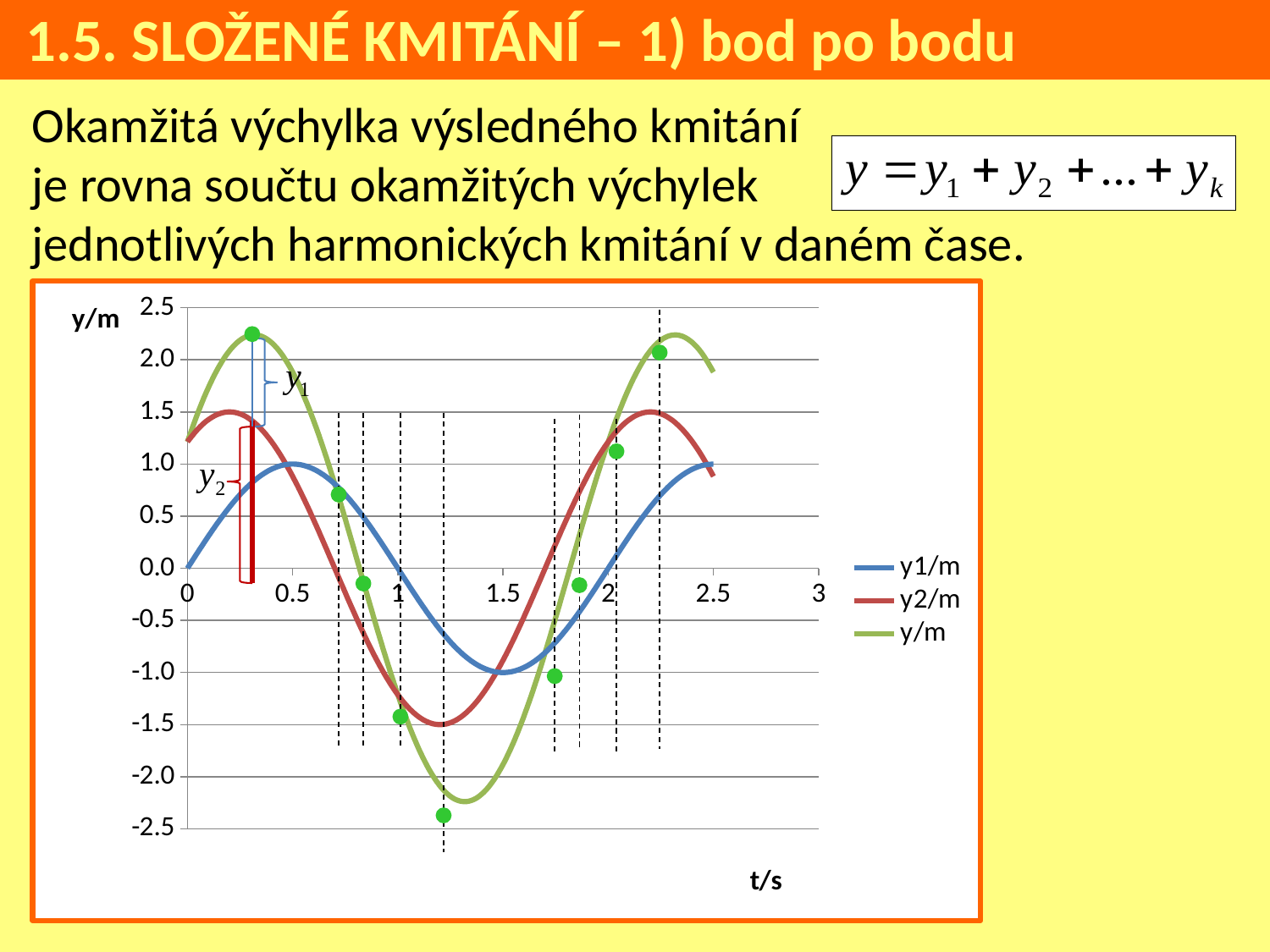
What kind of chart is shown on the slide? line chart What is the peak value of the y1/m series? 1.0 Which series reaches the highest peak value on the chart? y/m What is the peak value of the y2/m series? 1.5 How many series does the legend list? 3 Is the minimum value of the y/m series greater or less than -2.0? less Is the maximum value of the y/m series greater or less than 2.0? greater Which series has the larger peak value, y1/m or y2/m? y2/m Which series has the smallest amplitude (lowest peak)? y1/m What is the value of the y1/m series at t = 0? 0.0 What are the three series named in the legend? y1/m, y2/m, y/m What label is shown on the horizontal axis of the chart? t/s